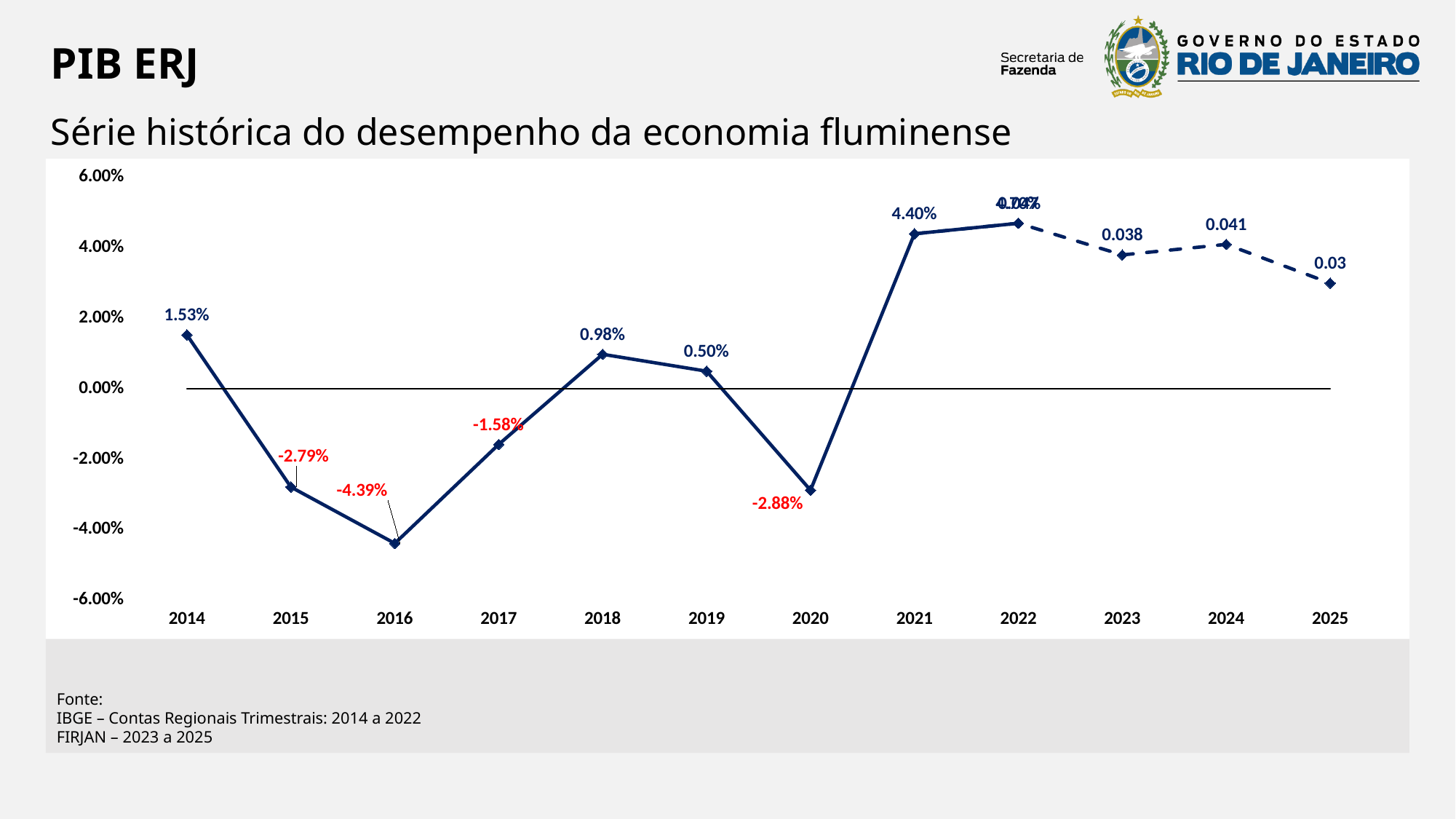
What is the value shown for 2025? 0.03 What is the value for 2016? -4.39% What kind of chart is shown? line chart Do the values rise or fall from 2014 to 2016? fall Which is larger, the value for 2015 or the value for 2020? 2015 What is the difference between the values for 2018 and 2019? 0.48 percentage points Which year has the lowest value? 2016 What is the value shown for 2024? 0.041 What is the value for 2014? 1.53% Is the value for 2022 greater or less than 4.00%? greater What is the value for 2021? 4.40% How many years are plotted on the chart? 12